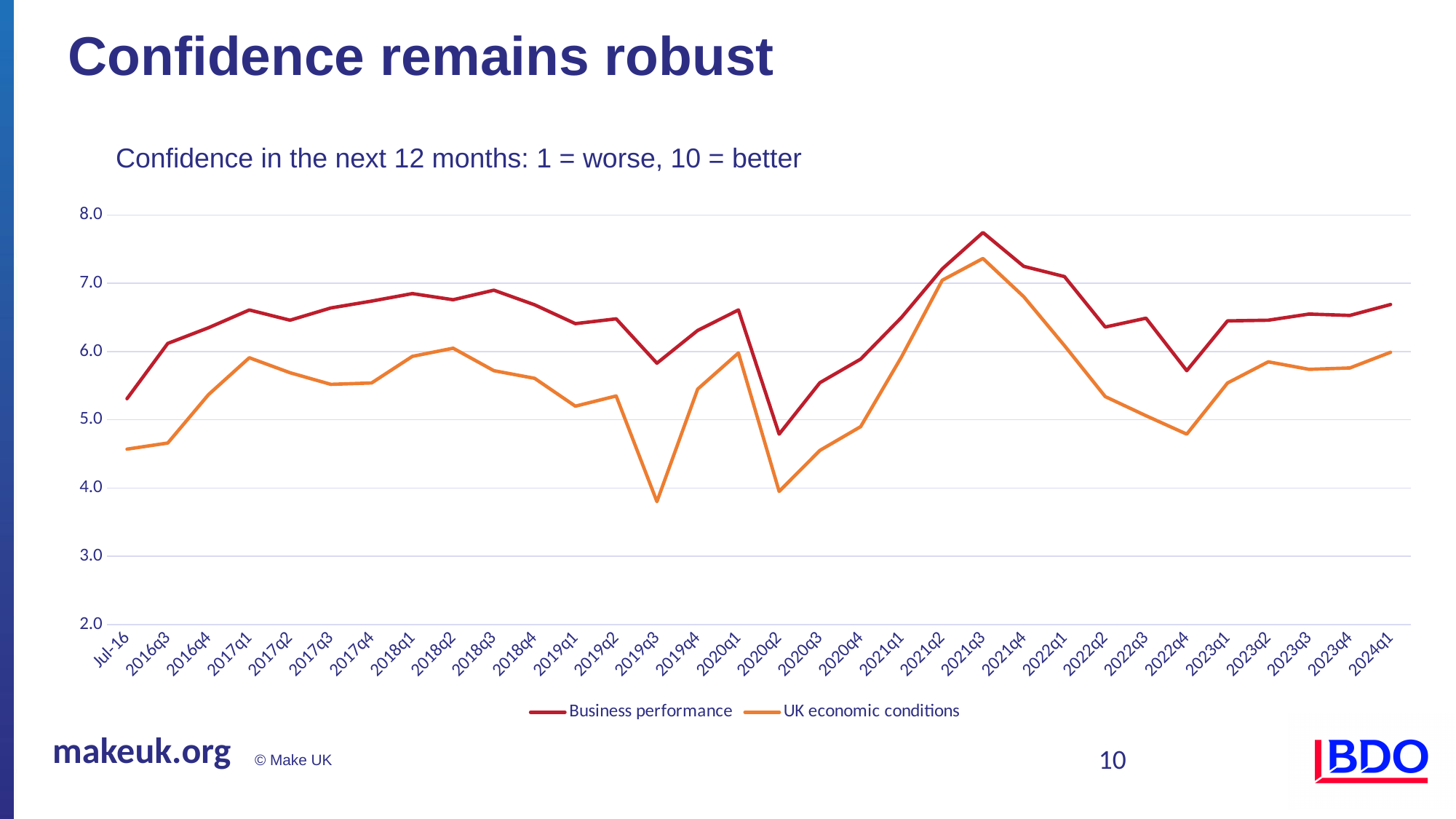
In 2024q1, which series has the higher value: Business performance or UK economic conditions? Business performance Is the value for UK economic conditions in 2019q3 greater or less than 4.0? less How many series does the legend list? 2 Is the value for Business performance in 2020q2 greater or less than 5.0? less In which period does the UK economic conditions line reach its highest value? 2021q3 In which period does the Business performance line reach its highest value? 2021q3 What kind of chart is shown on the slide? Line chart In which period does the Business performance line reach its lowest value? 2020q2 In which period does the UK economic conditions line reach its lowest value? 2019q3 Is the value for Business performance in 2024q1 greater or less than 6.0? greater Does the UK economic conditions line rise or fall between 2021q3 and 2022q4? Fall How many time periods are shown along the x axis? 32